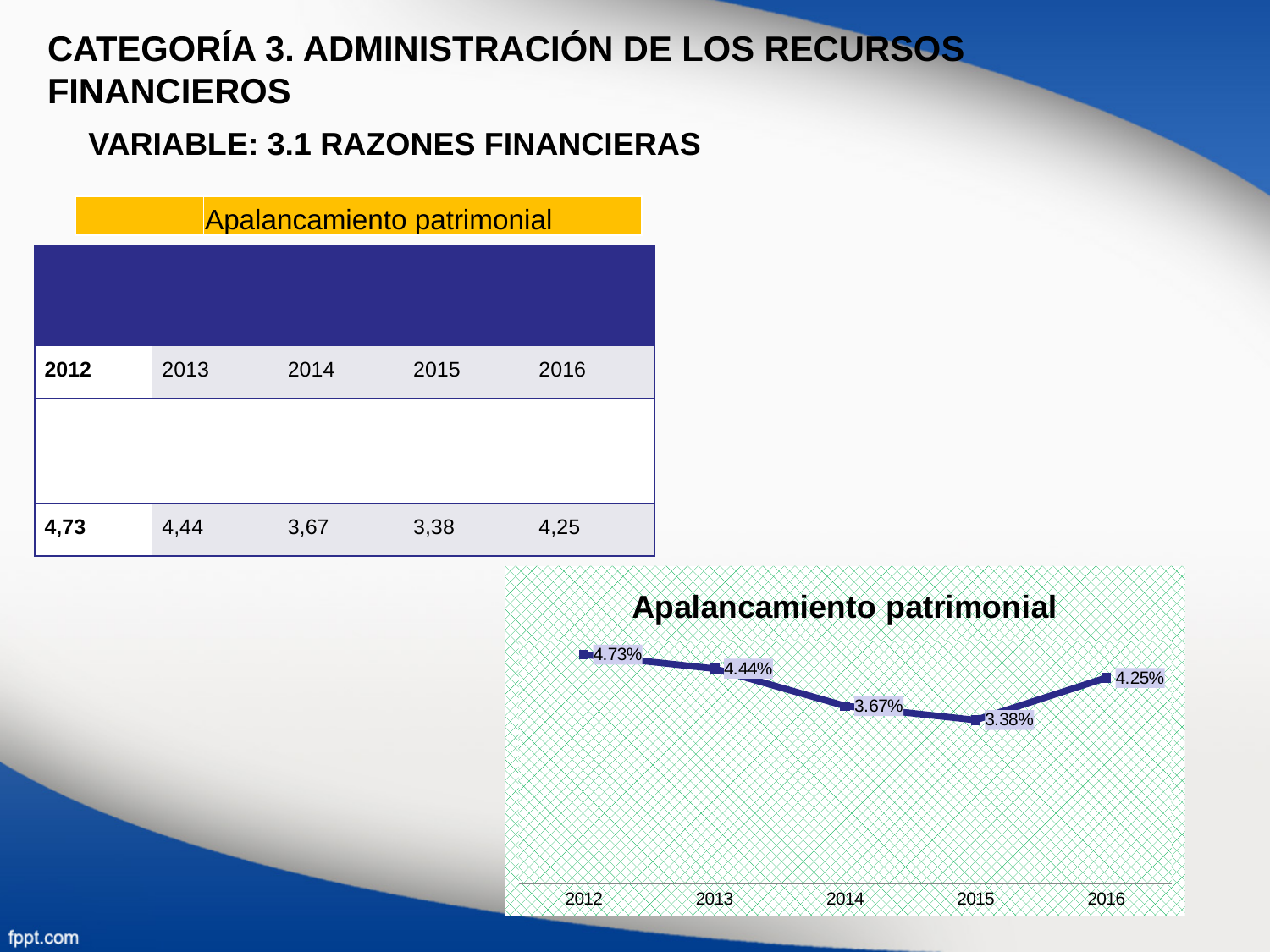
What is the title of the chart? Apalancamiento patrimonial Which year has the lowest value in the chart? 2015 What is the value for 2012 in the chart? 4.73% What is the difference between the values for 2012 and 2013? 0.29% What is the value for 2014 in the chart? 3.67% Which is larger, the value for 2013 or the value for 2016? 2013 How many years are plotted on the x axis of the chart? 5 What is the difference between the values for 2016 and 2015? 0.87% What kind of chart is shown on the slide? line chart Which year has the highest value in the chart? 2012 What is the value for 2016 in the chart? 4.25% Does the value rise or fall from 2012 to 2015? fall